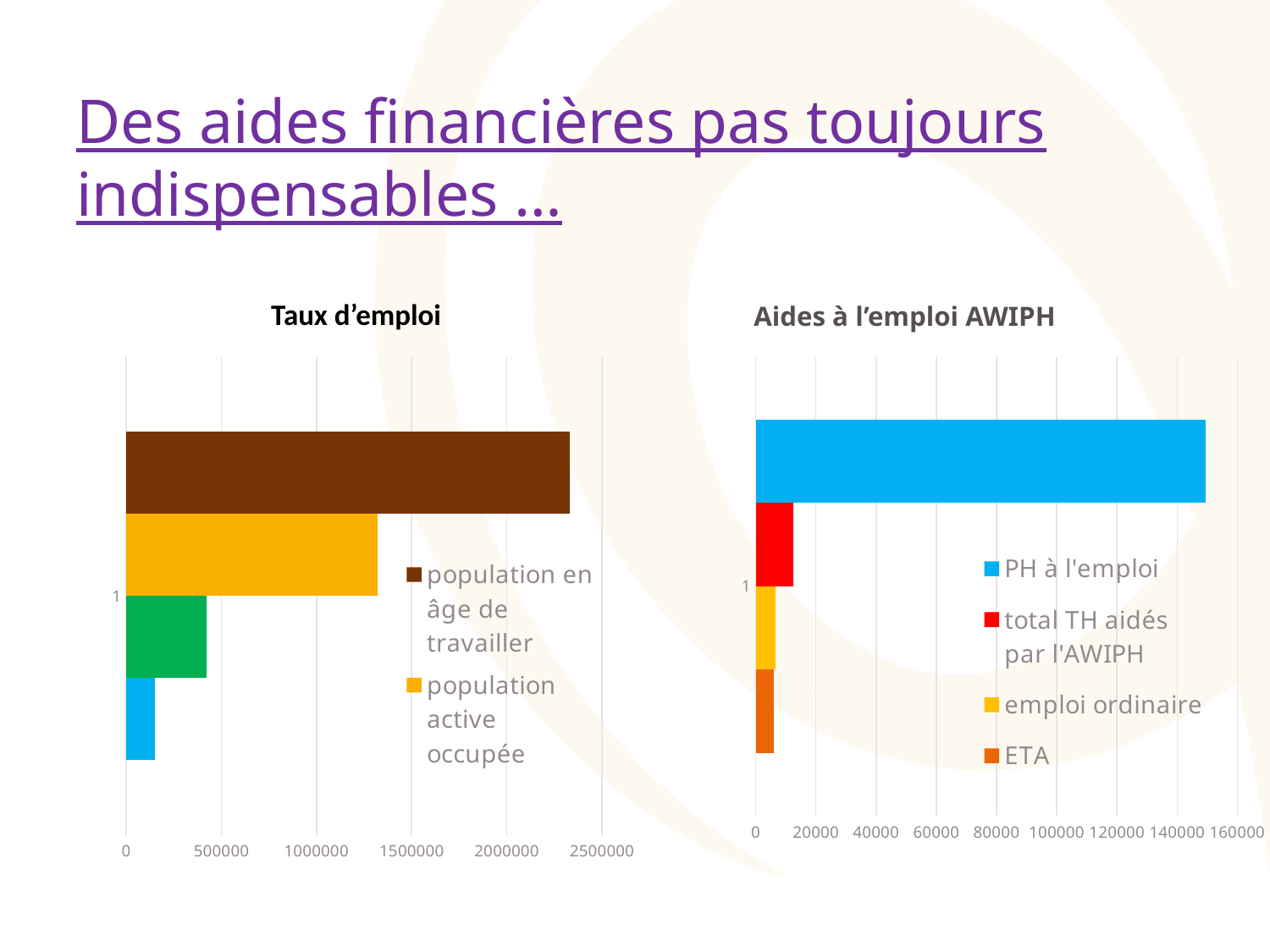
In the 'Aides à l'emploi AWIPH' chart, is the value for total TH aidés par l'AWIPH greater or less than 20000? less In the 'Taux d'emploi' chart, which is larger: population en âge de travailler or population active occupée? population en âge de travailler In the 'Taux d'emploi' chart, is the value for population en âge de travailler greater or less than 2000000? greater In the 'Taux d'emploi' chart, is the value for population active occupée greater or less than 1500000? less In the 'Aides à l'emploi AWIPH' chart, how many series does the legend list? 4 In the 'Aides à l'emploi AWIPH' chart, what colour is the bar for PH à l'emploi? blue In the 'Aides à l'emploi AWIPH' chart, which is larger: PH à l'emploi or total TH aidés par l'AWIPH? PH à l'emploi What kind of chart is the 'Aides à l'emploi AWIPH' chart on the right? bar chart In the 'Aides à l'emploi AWIPH' chart, which series has the highest value? PH à l'emploi What kind of chart is the 'Taux d'emploi' chart on the left? bar chart